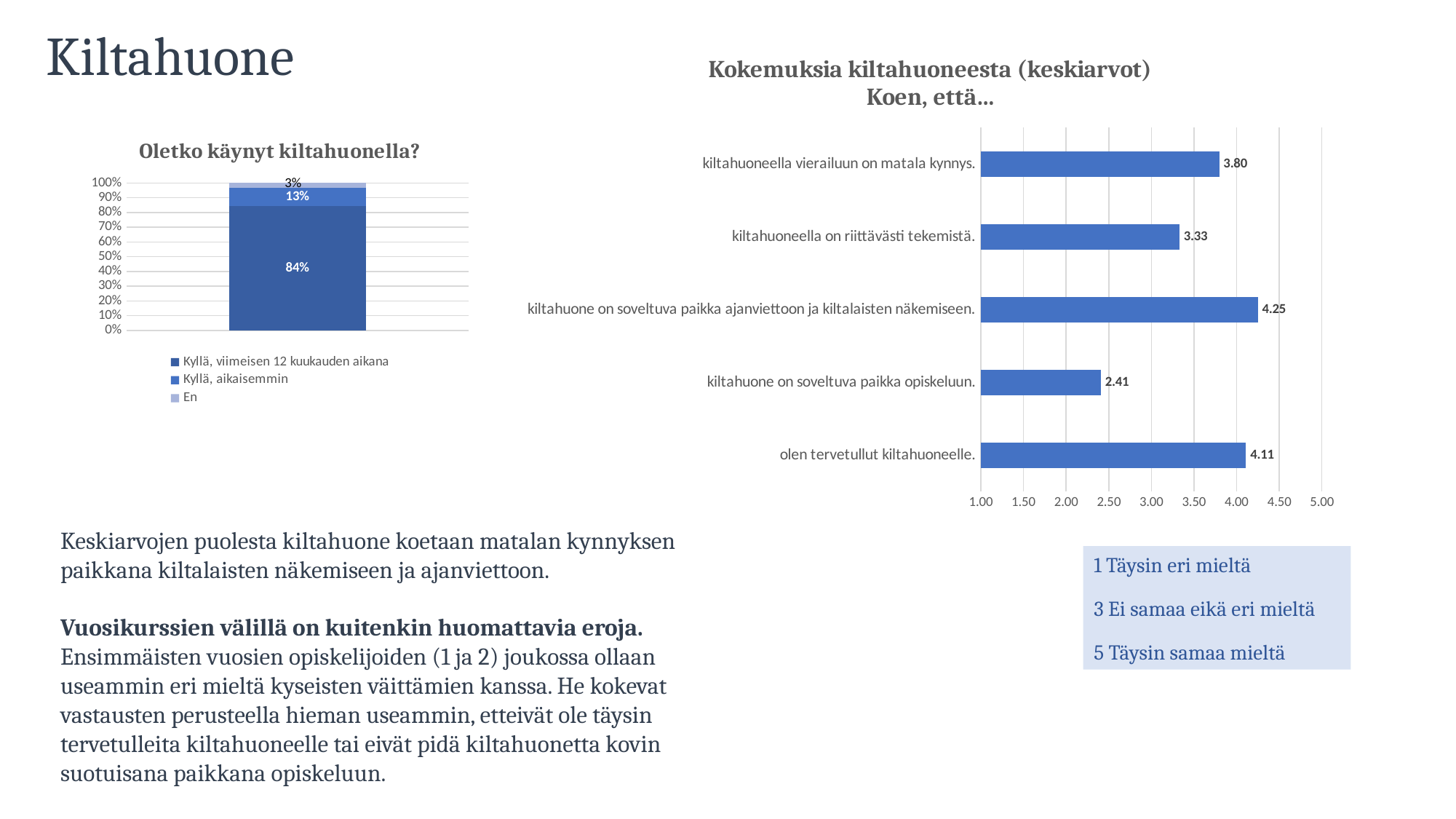
What kind of chart is the 'Kokemuksia kiltahuoneesta (keskiarvot)' chart? Bar chart In the 'Kokemuksia kiltahuoneesta (keskiarvot)' chart, what is the value for 'kiltahuone on soveltuva paikka opiskeluun.'? 2.41 In the 'Kokemuksia kiltahuoneesta (keskiarvot)' chart, what is the difference between the values for 'kiltahuoneella vierailuun on matala kynnys.' and 'kiltahuoneella on riittävästi tekemistä.'? 0.47 In the 'Kokemuksia kiltahuoneesta (keskiarvot)' chart, which statement has the lowest average? kiltahuone on soveltuva paikka opiskeluun. In the 'Oletko käynyt kiltahuonella?' chart, what is the difference between the 'Kyllä, viimeisen 12 kuukauden aikana' and 'Kyllä, aikaisemmin' percentages? 71% In the 'Oletko käynyt kiltahuonella?' chart, what percentage is shown for 'Kyllä, viimeisen 12 kuukauden aikana'? 84% In the 'Kokemuksia kiltahuoneesta (keskiarvot)' chart, what is the value for 'olen tervetullut kiltahuoneelle.'? 4.11 In the 'Kokemuksia kiltahuoneesta (keskiarvot)' chart, which statement has the highest average? kiltahuone on soveltuva paikka ajanviettoon ja kiltalaisten näkemiseen. In the 'Oletko käynyt kiltahuonella?' chart, what percentage is shown for 'En'? 3% In the 'Oletko käynyt kiltahuonella?' chart, how many series does the legend list? 3 How many statements are plotted in the 'Kokemuksia kiltahuoneesta (keskiarvot)' chart? 5 In the 'Kokemuksia kiltahuoneesta (keskiarvot)' chart, which is larger: the value for 'olen tervetullut kiltahuoneelle.' or 'kiltahuoneella vierailuun on matala kynnys.'? olen tervetullut kiltahuoneelle.